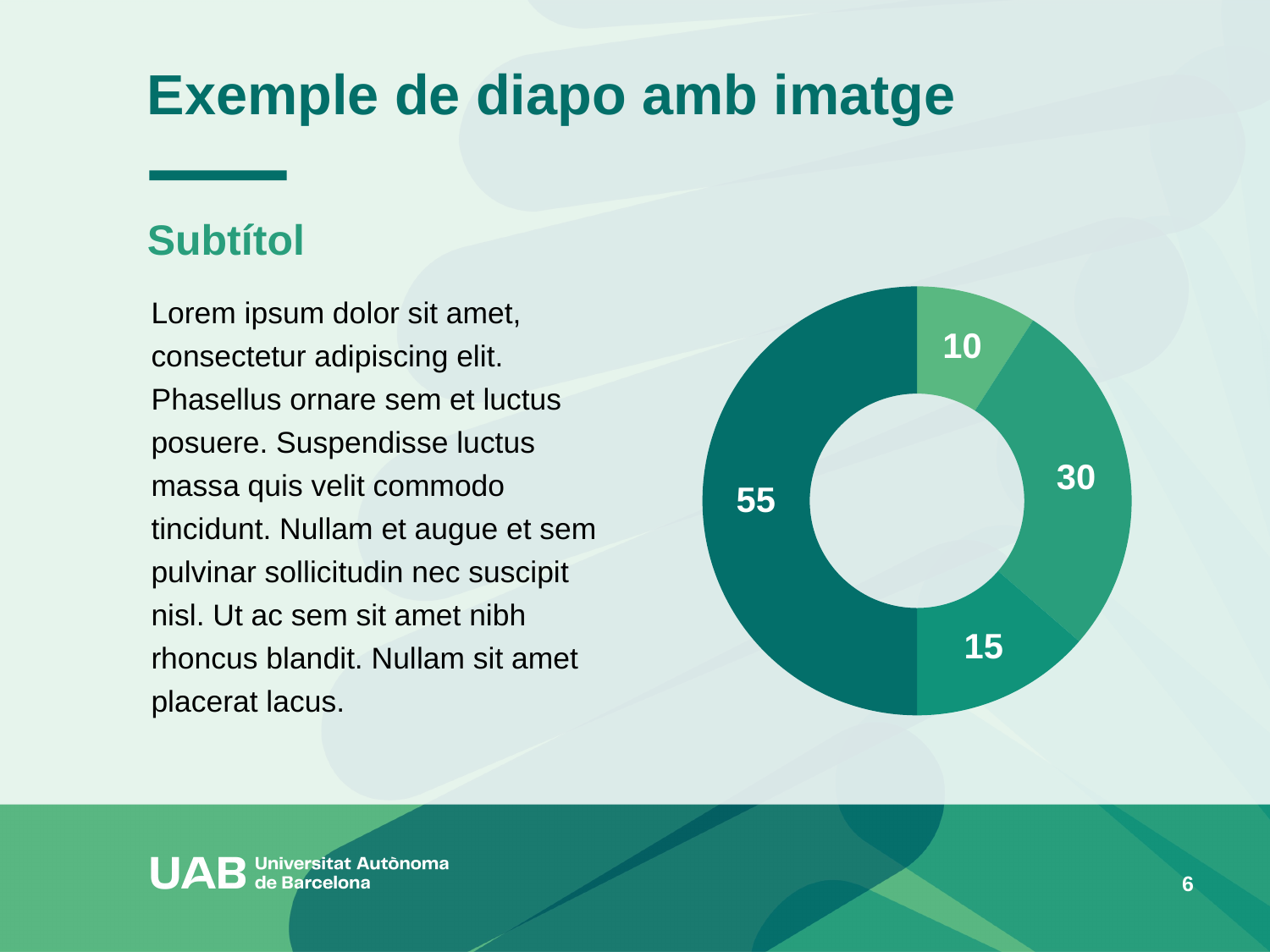
What is the difference between the largest slice (55) and the slice labelled 30? 25 What kind of chart is shown on the slide? doughnut chart What is the difference between the slice labelled 30 and the slice labelled 15? 15 What is the value of the smallest slice in the doughnut chart? 10 What is the value of the largest slice in the doughnut chart? 55 How many slices does the doughnut chart have? 4 What is the value shown on the darkest green slice of the doughnut chart? 55 What is the sum of all the slice values in the doughnut chart? 110 Which is larger, the slice on the right side of the doughnut or the slice at the bottom right? the slice on the right side (30) What share of the whole doughnut does the slice labelled 55 represent? 50% Which slice of the doughnut chart occupies the entire left half? the slice labelled 55 What is the value shown on the lightest green slice of the doughnut chart? 10